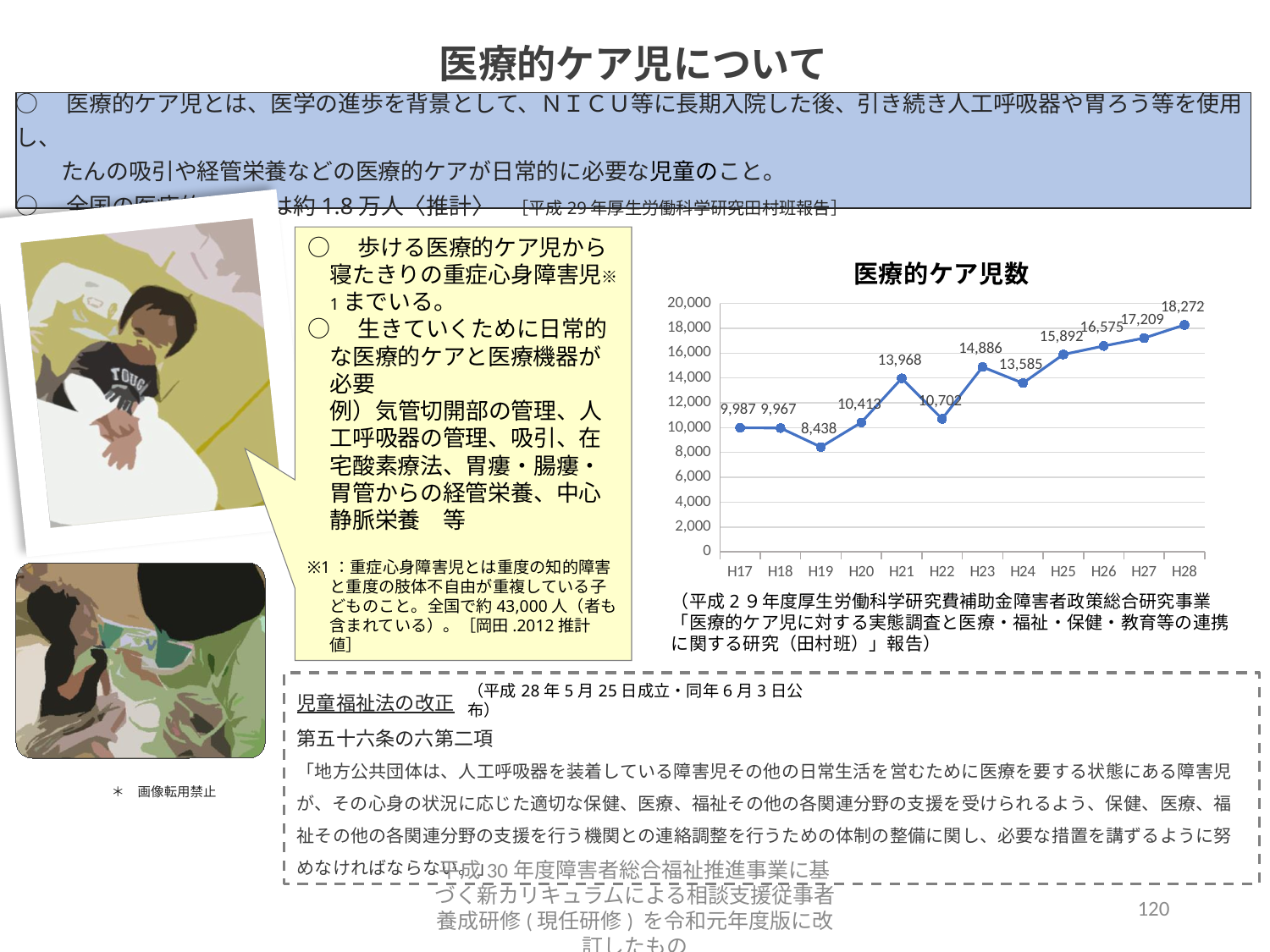
How many data points are plotted in the 医療的ケア児数 chart? 12 Which is larger in the 医療的ケア児数 chart, the value for H21 or the value for H24? H21 What is the value for H19 in the 医療的ケア児数 chart? 8,438 What is the title of the chart on the slide? 医療的ケア児数 Which year has the lowest value in the 医療的ケア児数 chart? H19 What is the difference between the H28 and H17 values in the 医療的ケア児数 chart? 8,285 What type of chart is used to show 医療的ケア児数? line chart What is the overall trend of the values from H17 to H28 in the 医療的ケア児数 chart? rising What is the difference between the H21 and H22 values in the 医療的ケア児数 chart? 3,266 What is the value for H23 in the 医療的ケア児数 chart? 14,886 What is the value for H28 in the 医療的ケア児数 chart? 18,272 Which year has the highest value in the 医療的ケア児数 chart? H28